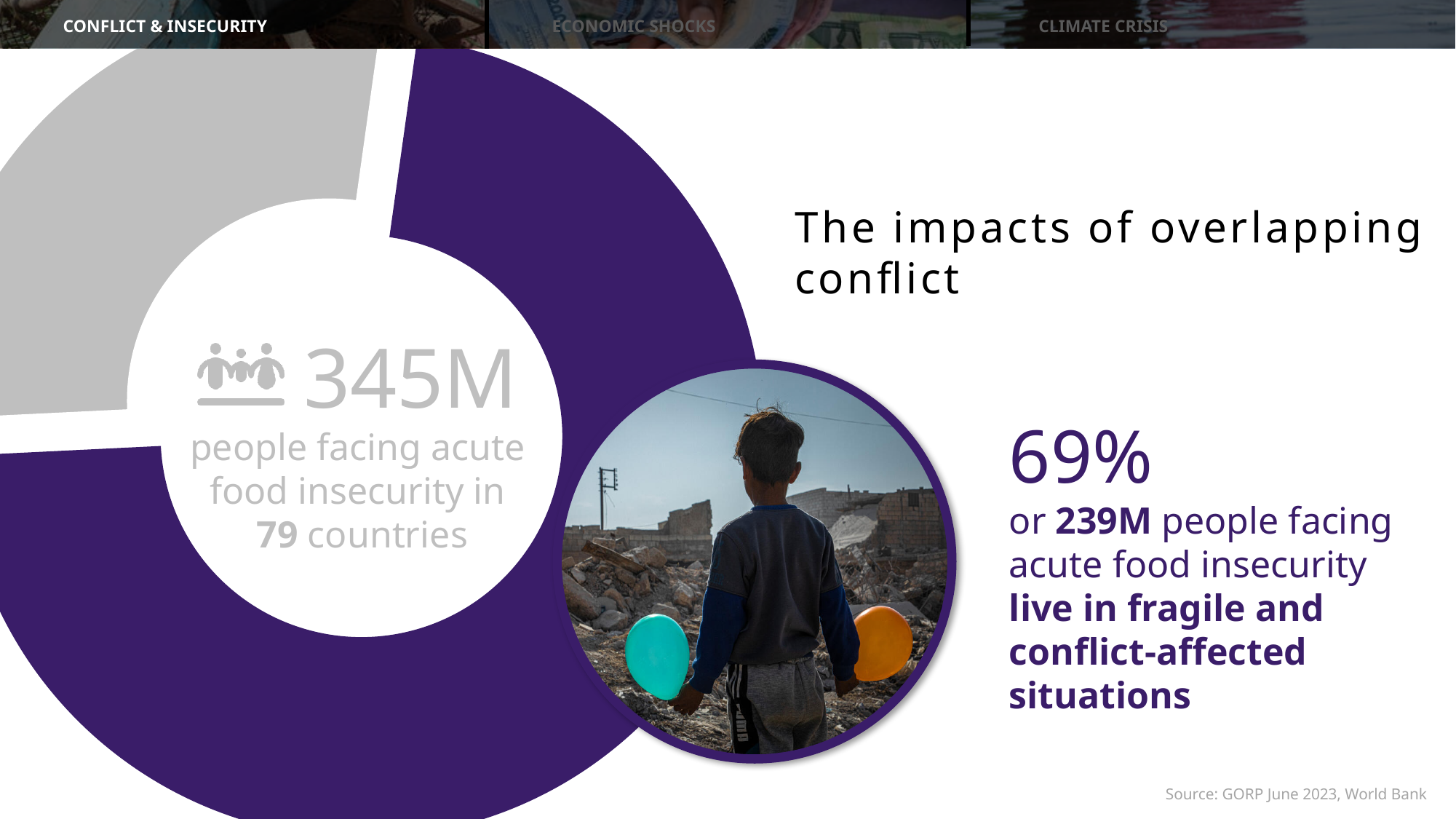
What is the title text shown to the right of the donut chart? The impacts of overlapping conflict What total number of people facing acute food insecurity is shown in the centre of the donut chart? 345M What is the difference between the total of 345M and the 239M represented by the purple segment? 106M Which segment of the donut chart is larger, the purple one or the grey one? Purple In how many countries are the 345M people facing acute food insecurity, according to the donut chart? 79 How many people does the purple segment (69%) of the donut chart represent? 239M What does the purple segment of the donut chart represent? People facing acute food insecurity who live in fragile and conflict-affected situations Is the share of the purple segment in the donut chart greater or less than 50%? greater How many segments does the donut chart have? 2 What kind of chart is shown on the left of the slide? Donut (pie) chart